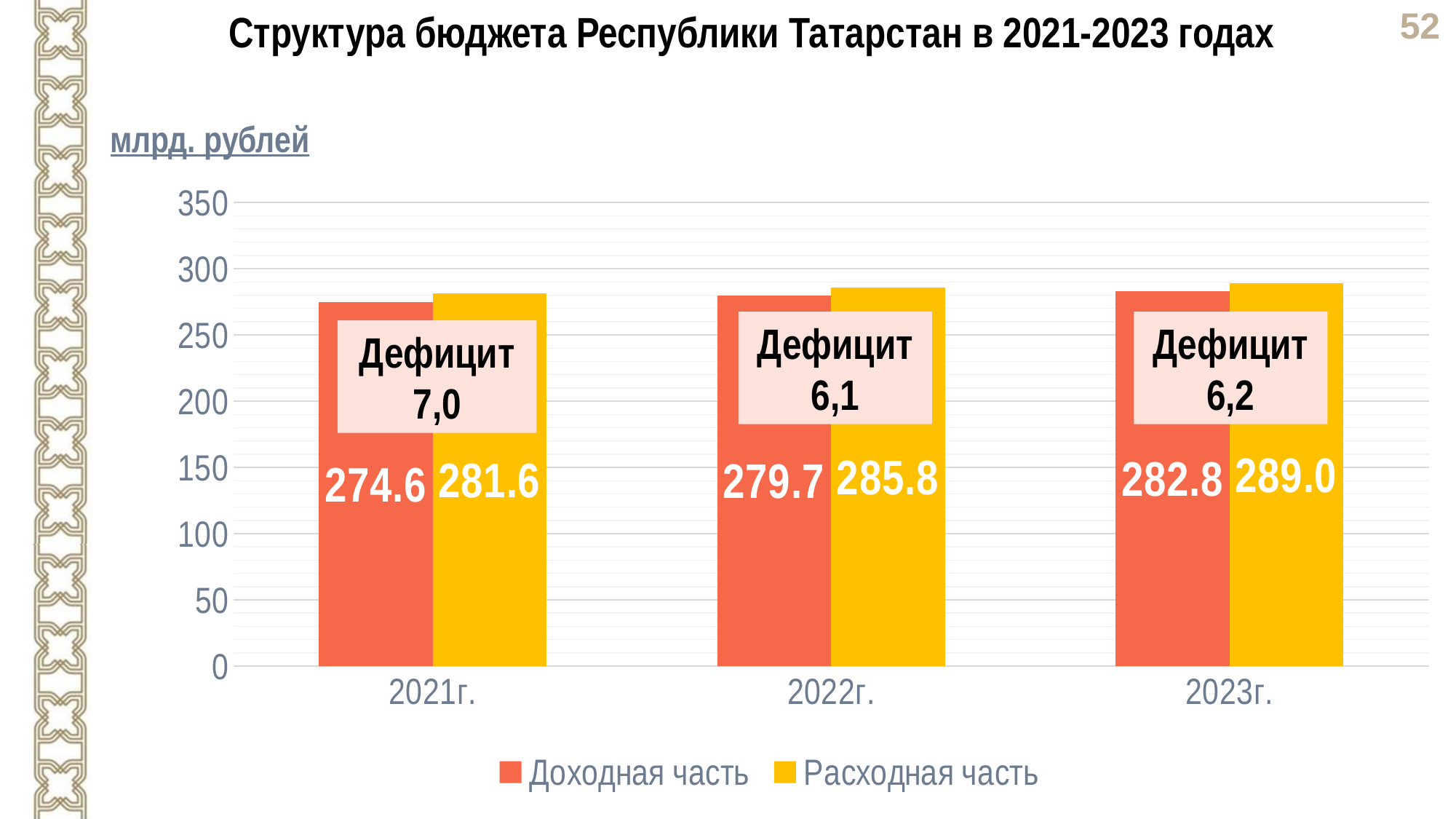
Which year has the highest value for Доходная часть? 2023г. Does the value of Доходная часть rise or fall from 2021г. to 2023г.? rise Is the value of Доходная часть for 2021г. greater or less than 300? less What is the value of Доходная часть for 2021г.? 274.6 Which is larger in 2023г.: Доходная часть or Расходная часть? Расходная часть What kind of chart is shown on the slide? bar chart How many years are shown on the x axis? 3 What is the value of Расходная часть for 2022г.? 285.8 What is the difference between Расходная часть and Доходная часть in 2022г.? 6.1 Which year has the lowest value for Расходная часть? 2021г. How many series does the legend list? 2 What is the value of Расходная часть for 2023г.? 289.0